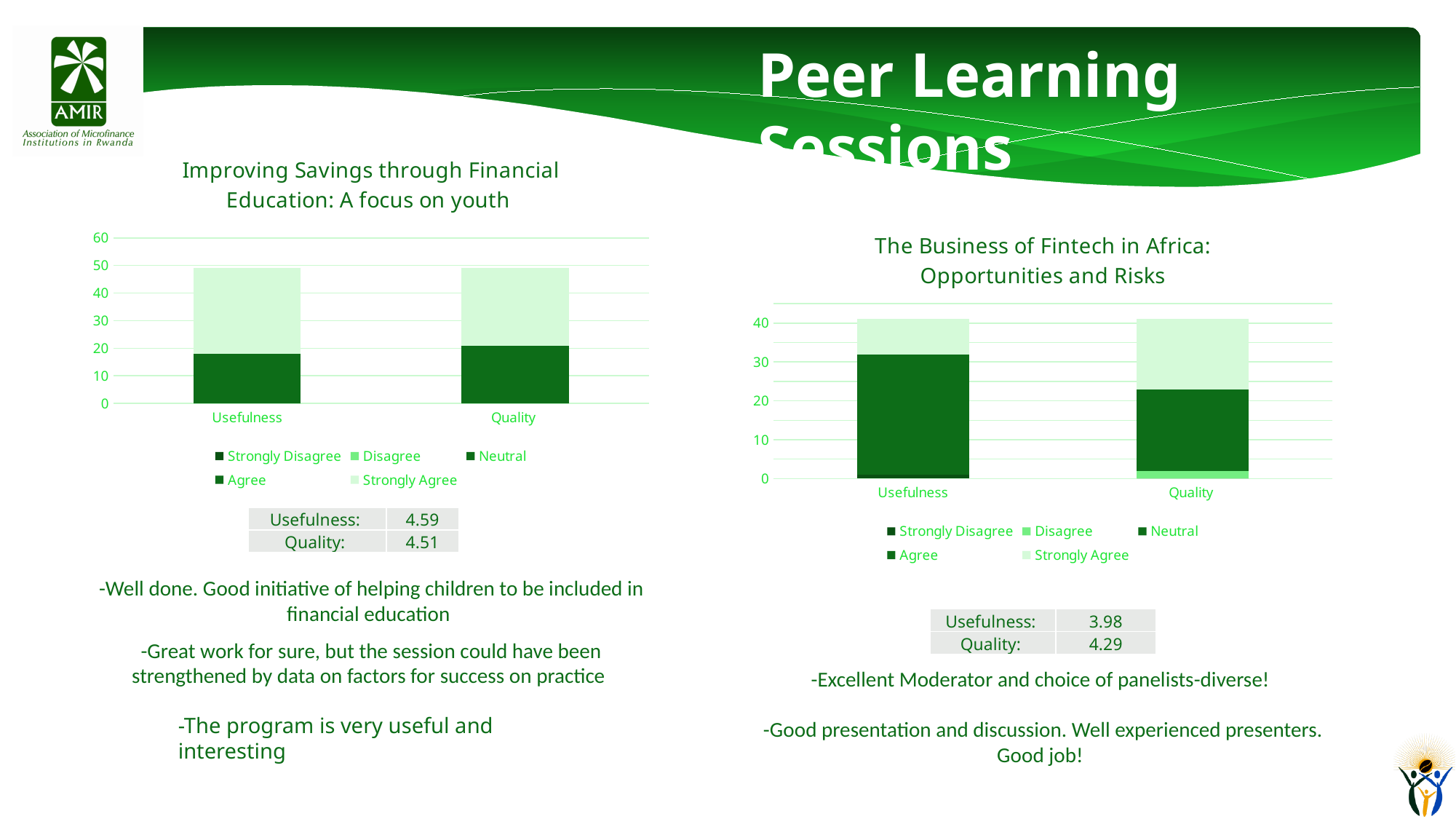
In the 'Improving Savings through Financial Education: A focus on youth' chart, is the total height of the Usefulness bar greater or less than 40? greater What is the highest value shown on the y axis of the 'Improving Savings through Financial Education: A focus on youth' chart? 60 How many categories are shown on the x axis of the 'Improving Savings through Financial Education: A focus on youth' chart? 2 What kind of chart is the 'Improving Savings through Financial Education: A focus on youth' chart? Stacked bar chart What are the two categories on the x axis of the 'The Business of Fintech in Africa: Opportunities and Risks' chart? Usefulness and Quality In the 'The Business of Fintech in Africa: Opportunities and Risks' chart, which category has the larger Agree segment, Usefulness or Quality? Usefulness In the 'The Business of Fintech in Africa: Opportunities and Risks' chart, is the total height of the Quality bar greater or less than 30? greater In the 'The Business of Fintech in Africa: Opportunities and Risks' chart, is the Agree segment for Usefulness greater or less than 20? greater In the 'The Business of Fintech in Africa: Opportunities and Risks' chart, which category has the larger Strongly Agree segment, Usefulness or Quality? Quality In the 'Improving Savings through Financial Education: A focus on youth' chart, which category has the larger Agree segment, Usefulness or Quality? Quality How many series does the legend of the 'The Business of Fintech in Africa: Opportunities and Risks' chart list? 5